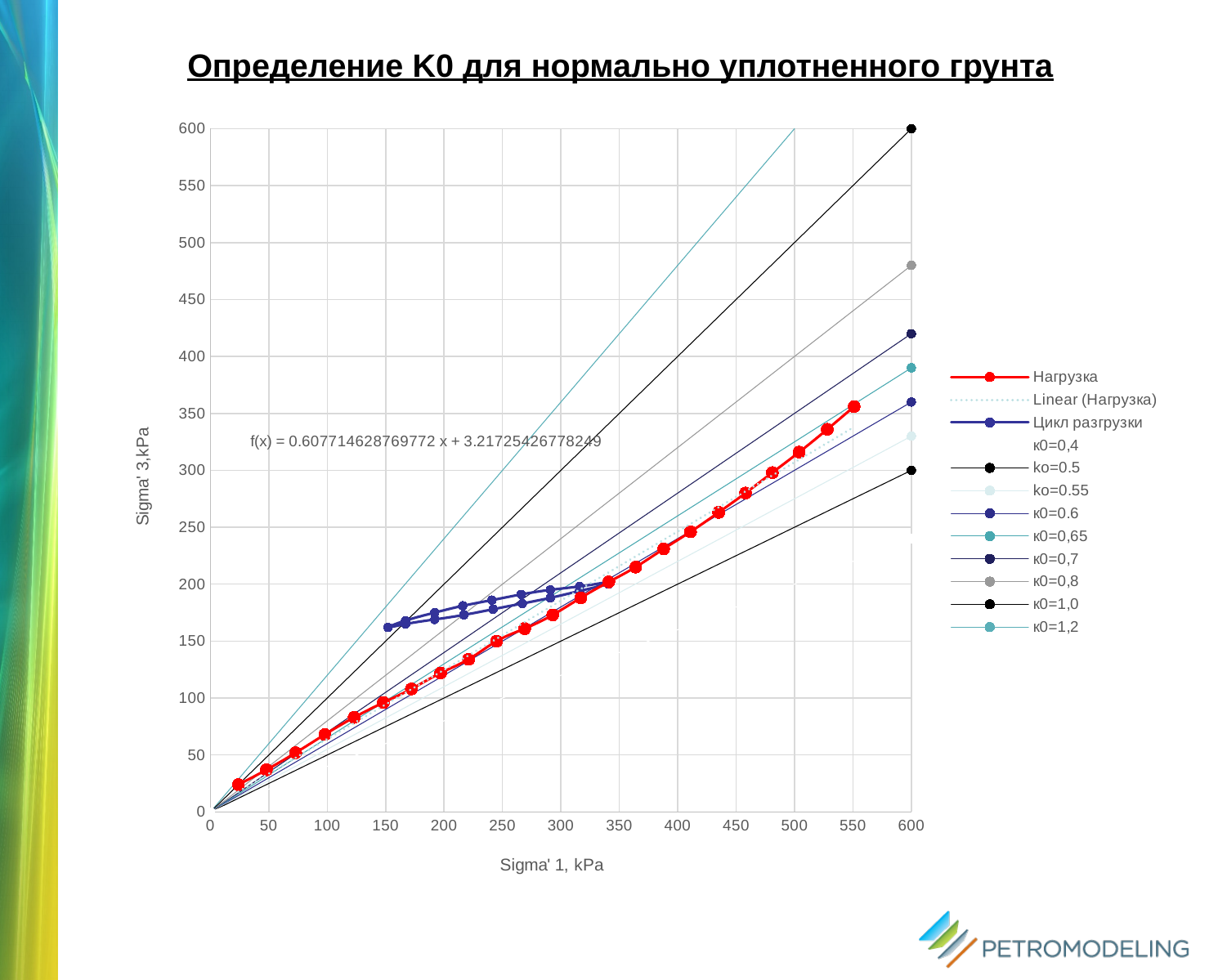
Which k0 line is the lowest on the chart? ko=0.5 Is the value of the Нагрузка series at Sigma' 1 = 550 kPa greater or less than 300? greater Which k0 line is the steepest (highest) on the chart? к0=1,2 Which of the two lines, к0=1,0 or к0=0,8, has the higher value at Sigma' 1 = 600 kPa? к0=1,0 What type of chart is shown on the slide? line chart How many series does the legend list? 12 Is the first point of the Цикл разгрузки series (at Sigma' 1 ≈ 150 kPa) greater or less than 150 on the y axis? greater What is the value of the к0=1,0 line at Sigma' 1 = 600 kPa? 600 What is the label of the x axis? Sigma' 1, kPa What is the value of the ko=0.5 line at Sigma' 1 = 600 kPa? 300 What is the title of the chart? Определение K0 для нормально уплотненного грунта Do the values of the Нагрузка series rise or fall as Sigma' 1 increases? rise